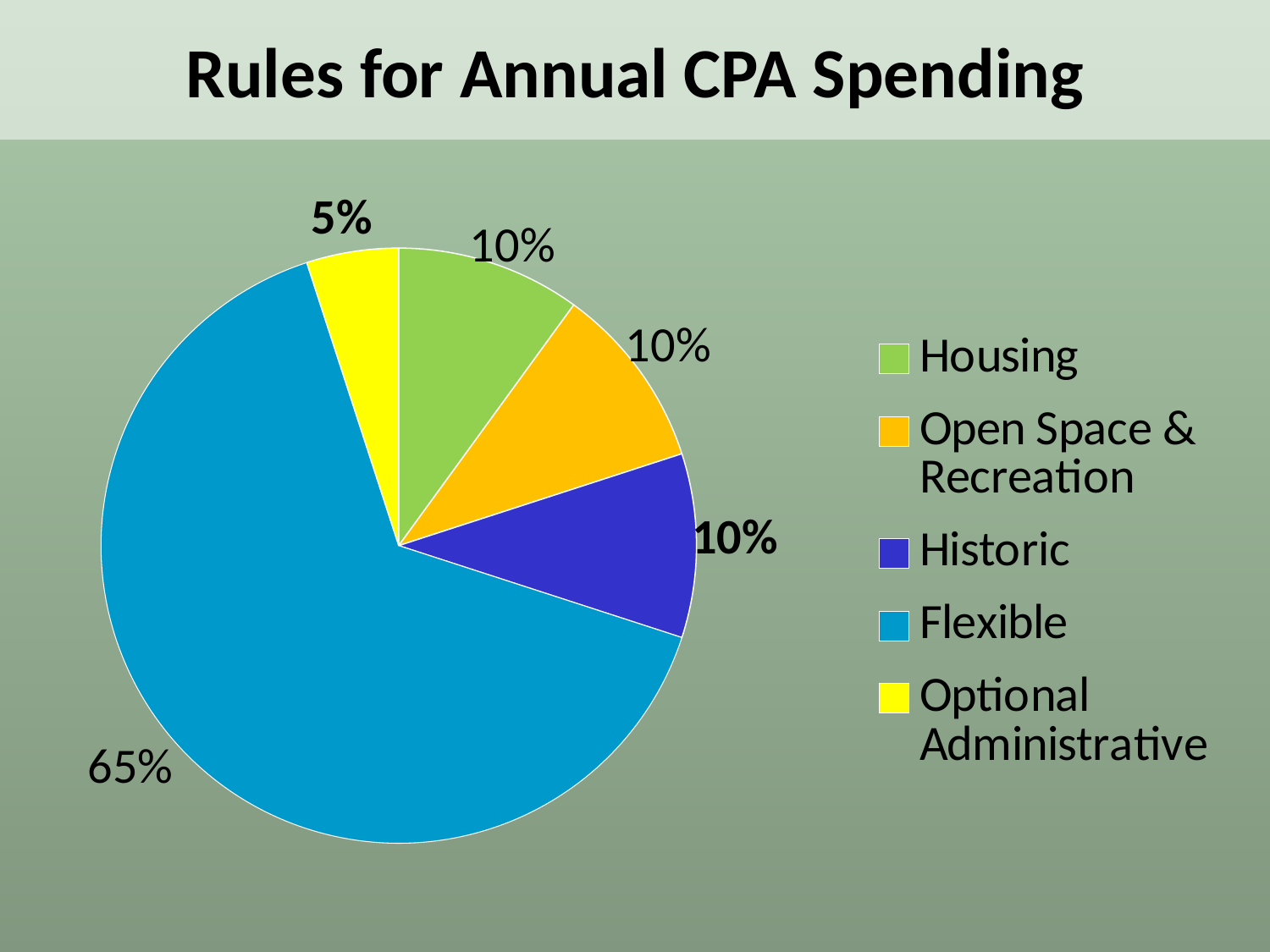
Which colour represents Open Space & Recreation in the legend? orange What share of the pie does Flexible represent? 65% How many categories does the pie chart show? 5 What share of the pie does Historic represent? 10% Which is larger, the Historic slice or the Optional Administrative slice? Historic What share of the pie does Optional Administrative represent? 5% What is the title of the chart? Rules for Annual CPA Spending What is the difference between the Flexible share and the Housing share? 55% Which category has the largest slice of the pie? Flexible What kind of chart is shown on the slide? pie chart Which category has the smallest slice of the pie? Optional Administrative